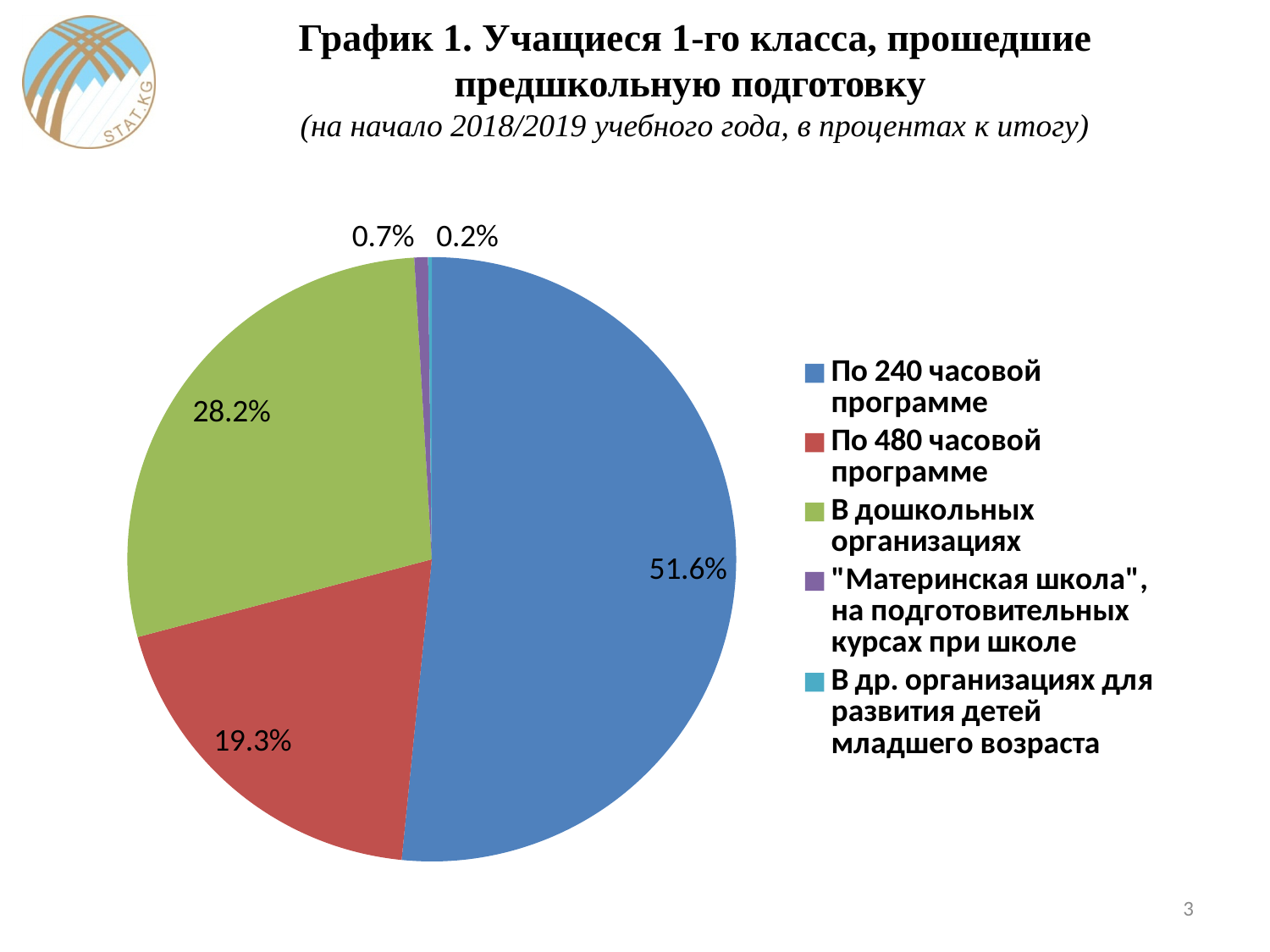
What share of the pie is labelled for "По 240 часовой программе"? 51.6% How many categories does the legend list? 5 What share of the pie is labelled for "В дошкольных организациях"? 28.2% What share of the pie is labelled for "По 480 часовой программе"? 19.3% Which is larger: the share for "По 480 часовой программе" or for "В дошкольных организациях"? В дошкольных организациях What share of the pie is labelled for "В др. организациях для развития детей младшего возраста"? 0.2% What share of the pie is labelled for "Материнская школа", на подготовительных курсах при школе? 0.7% What is the difference in percentage points between "По 240 часовой программе" and "В дошкольных организациях"? 23.4 Which category has the smallest slice of the pie? В др. организациях для развития детей младшего возраста What colour is the slice for "По 480 часовой программе"? Red What kind of chart is shown on the slide? Pie chart Which category has the largest slice of the pie? По 240 часовой программе